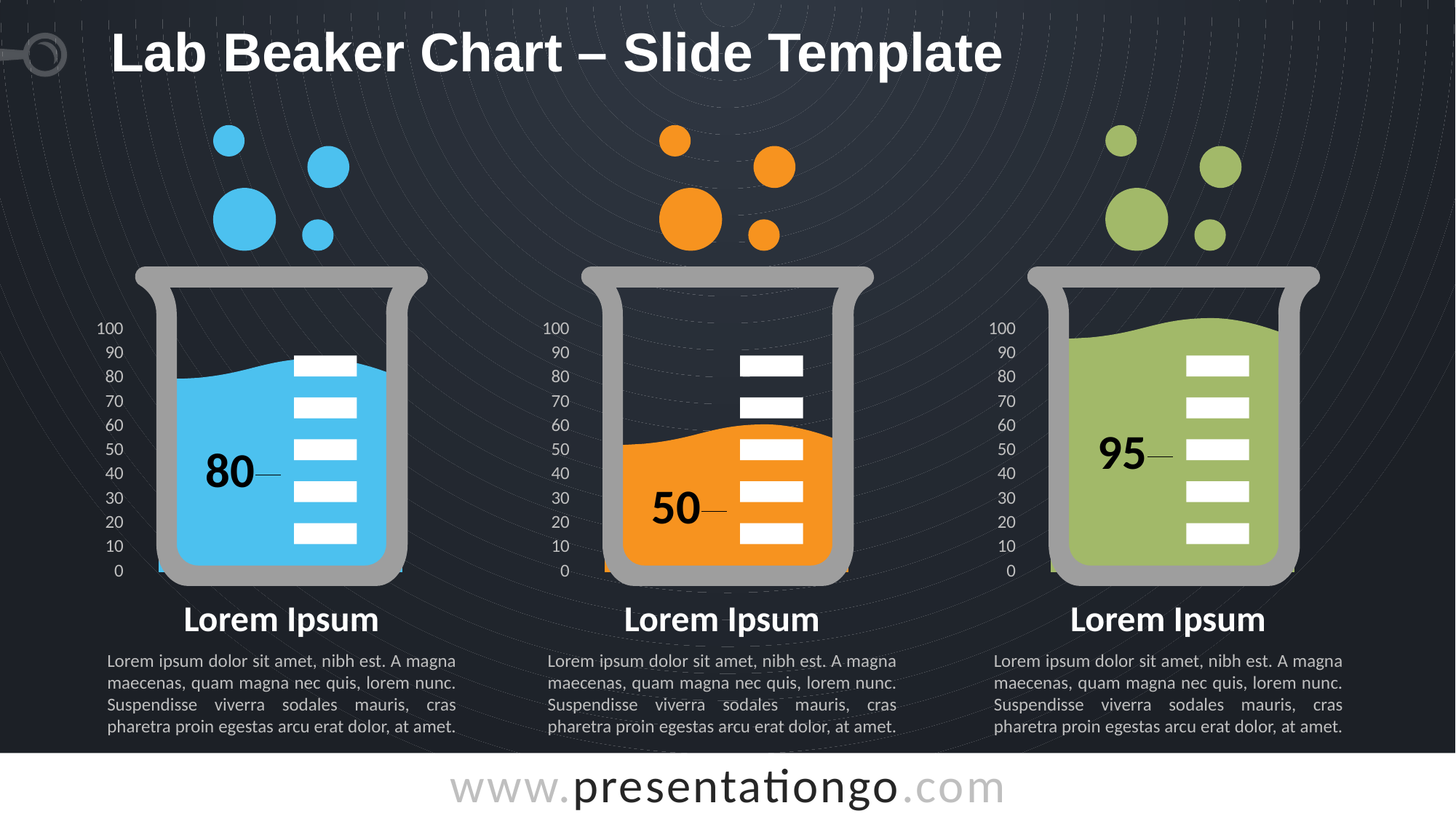
Which beaker chart shows the lowest value: left, middle or right? middle What value is shown in the right beaker chart? 95 Which is larger, the value in the left beaker chart or the value in the middle beaker chart? left What is the maximum value on the scale beside each beaker chart? 100 What value is shown in the middle beaker chart? 50 How many beaker charts are shown on the slide? 3 What is the difference between the values in the right beaker chart and the middle beaker chart? 45 What is the difference between the values in the left beaker chart and the middle beaker chart? 30 Which beaker chart shows the highest value: left, middle or right? right Is the value in the middle beaker chart greater or less than 60? less What colour is the liquid in the middle beaker chart? orange What value is shown in the left beaker chart? 80